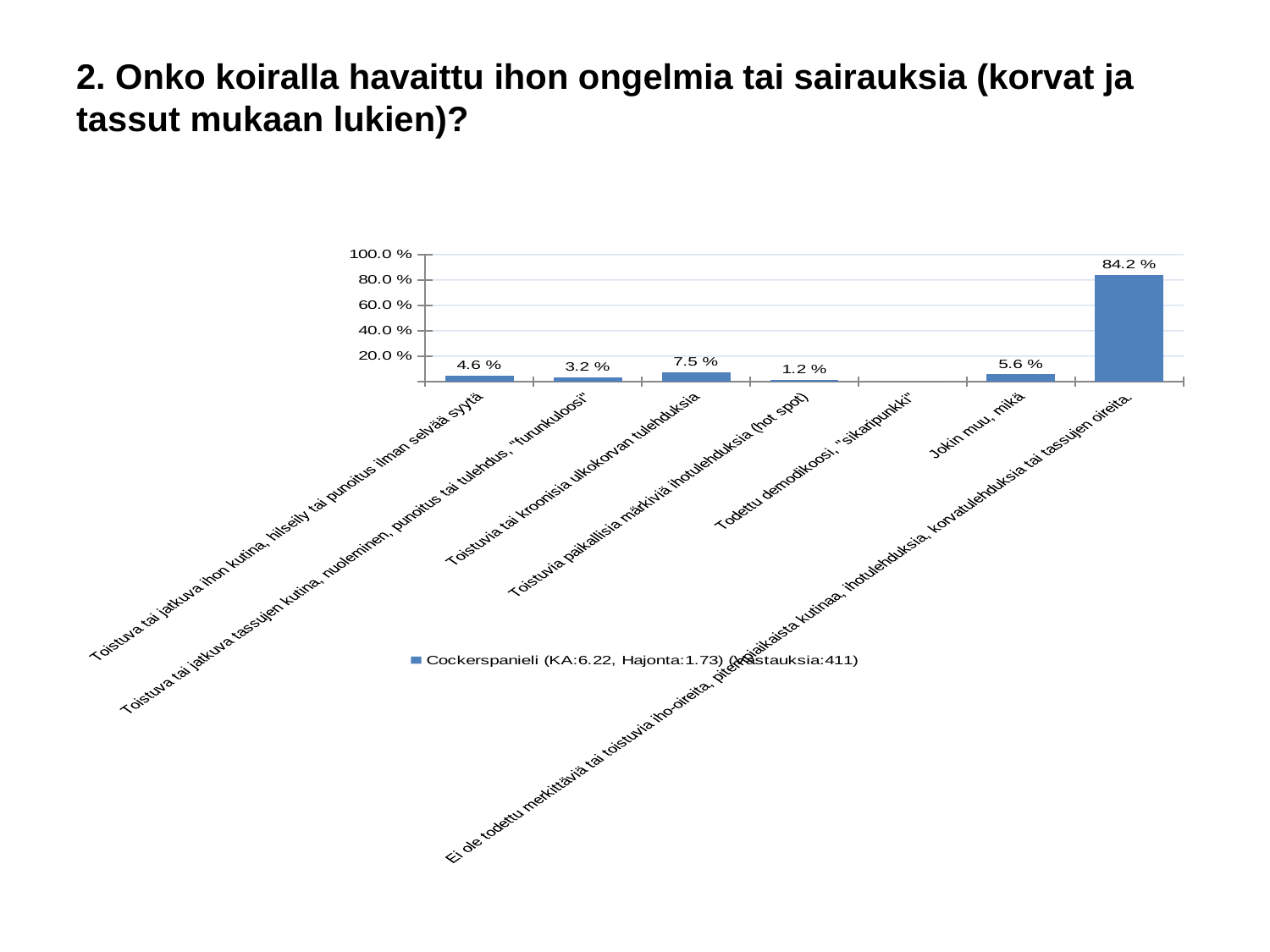
What is the value for "Toistuva tai jatkuva ihon kutina, hilseily tai punoitus ilman selvää syytä"? 4.6 % Which category has the highest value? Ei ole todettu merkittäviä tai toistuvia iho-oireita, pitempiaikaista kutinaa, ihotulehduksia, korvatulehduksia tai tassujen oireita. What kind of chart is shown on the slide? bar chart How many categories are shown on the x axis? 7 Which is larger: the value for "Toistuva tai jatkuva tassujen kutina, nuoleminen, punoitus tai tulehdus, "furunkuloosi"" or the value for "Toistuvia paikallisia märkiviä ihotulehduksia (hot spot)"? Toistuva tai jatkuva tassujen kutina, nuoleminen, punoitus tai tulehdus, "furunkuloosi" What is the legend entry for the series? Cockerspanieli (KA:6.22, Hajonta:1.73) (Vastauksia:411) What is the value for "Jokin muu, mikä"? 5.6 % Is the value for "Ei ole todettu merkittäviä tai toistuvia iho-oireita..." greater or less than 80.0 %? greater What is the value for "Toistuvia paikallisia märkiviä ihotulehduksia (hot spot)"? 1.2 % What is the value for "Toistuvia tai kroonisia ulkokorvan tulehduksia"? 7.5 % What is the difference between the highest value (84.2 %) and the value for "Toistuvia tai kroonisia ulkokorvan tulehduksia"? 76.7 % How many series does the legend list? 1